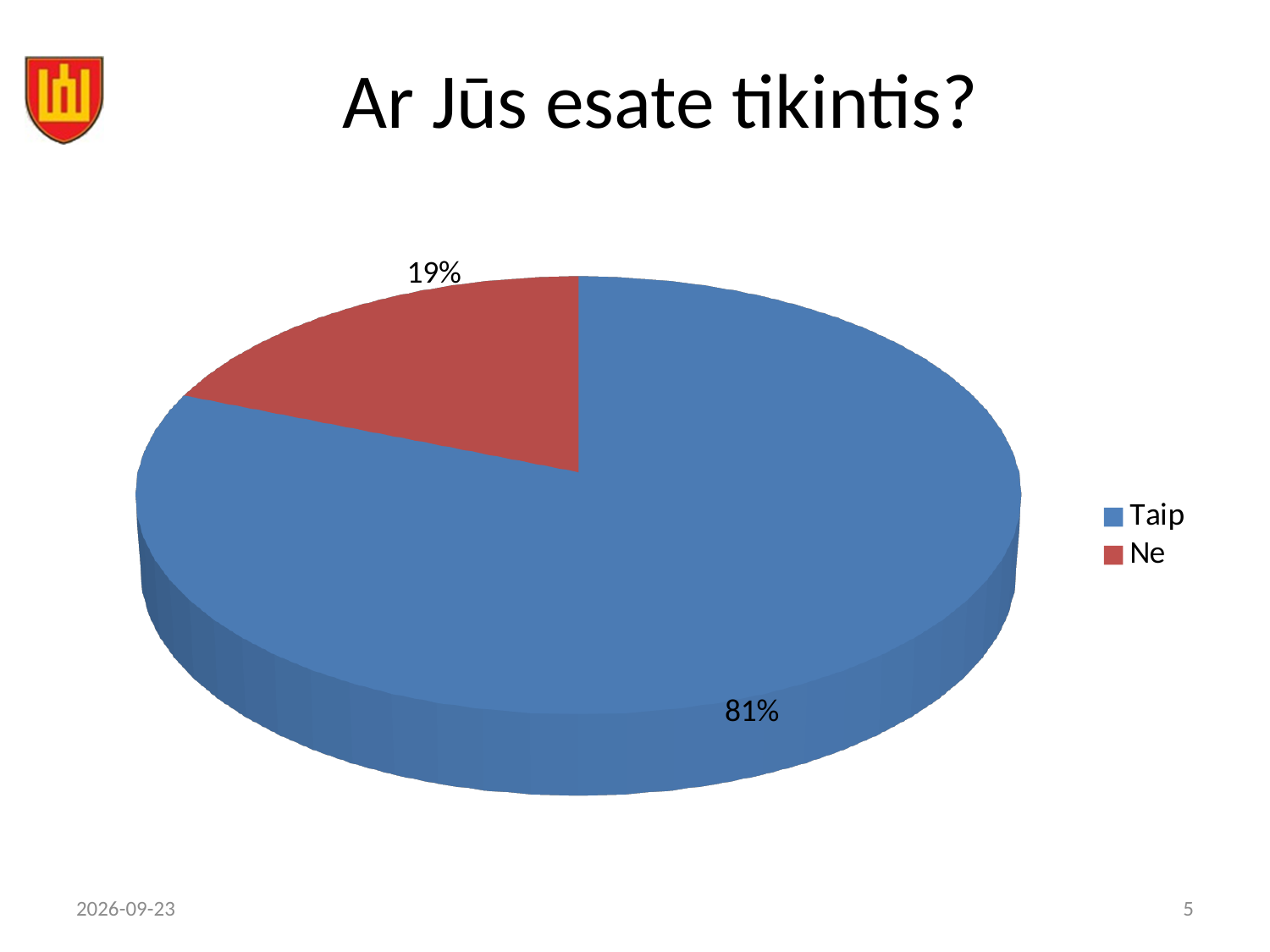
Which category has the largest slice of the pie? Taip What colour is the "Ne" slice in the pie chart? Red What share of the pie does the "Ne" slice represent? 19% What is the difference in percentage points between the "Taip" and "Ne" slices? 62 Which slice is larger, "Taip" or "Ne"? Taip How many categories are shown in the pie chart? 2 Which category has the smallest slice of the pie? Ne What share of the pie does the "Taip" slice represent? 81% What kind of chart is shown on the slide? Pie chart What is the title of the slide containing the chart? Ar Jūs esate tikintis? How many entries does the legend list? 2